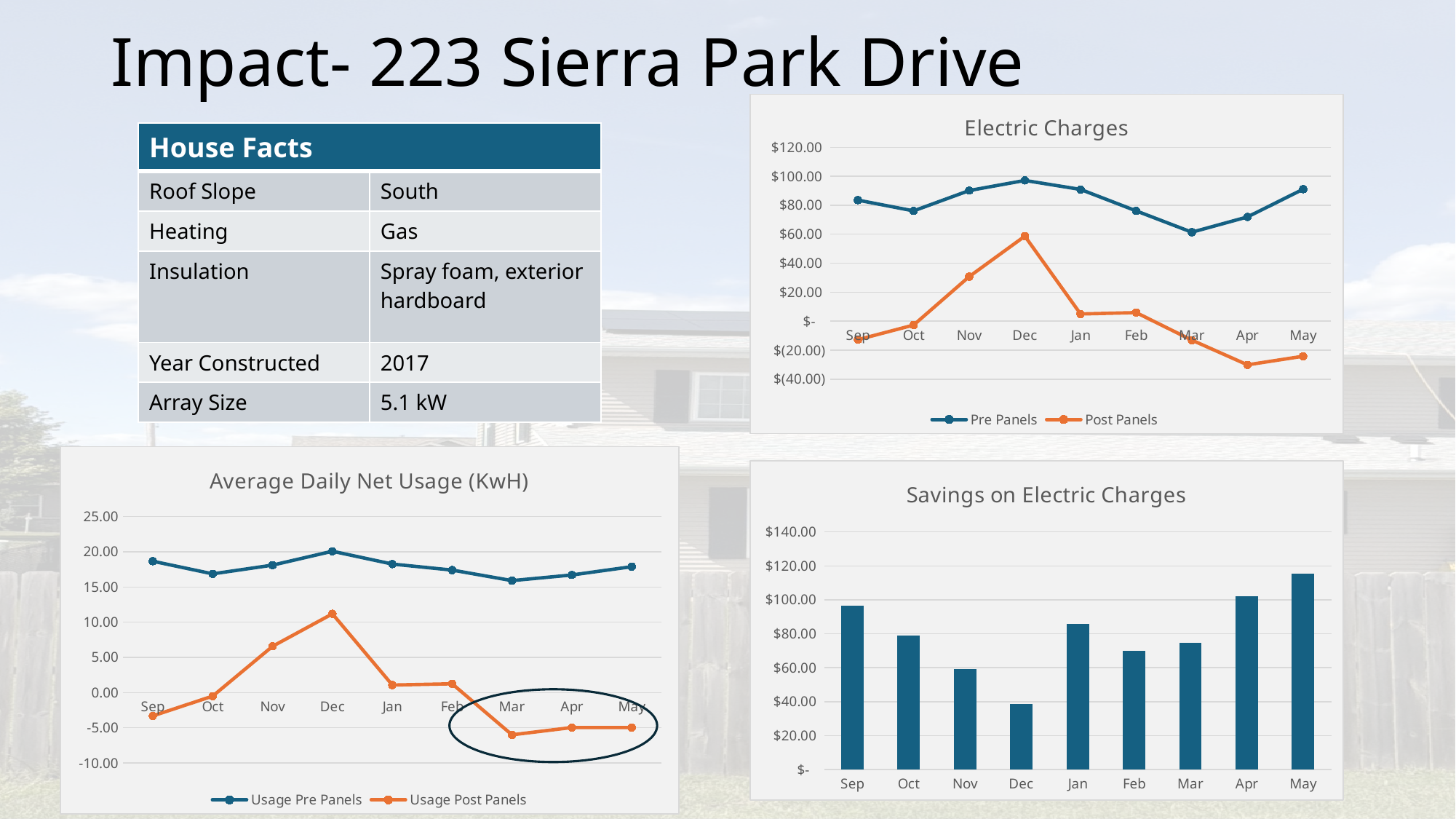
In the 'Savings on Electric Charges' chart, which month has the lowest savings? Dec In the 'Electric Charges' chart, is the Post Panels value for Dec greater or less than $40.00? greater What kind of chart is the 'Savings on Electric Charges' chart? bar chart In the 'Electric Charges' chart, in which month does the Pre Panels series reach its highest value? Dec In the 'Savings on Electric Charges' chart, is the value for May greater or less than $100.00? greater What kind of chart is the 'Electric Charges' chart? line chart How many months are shown on the x axis of the 'Savings on Electric Charges' chart? 9 In the 'Savings on Electric Charges' chart, which is larger, the savings for Sep or for Oct? Sep In the 'Average Daily Net Usage (KwH)' chart, is the Usage Post Panels value for Mar greater or less than 0.00? less In the 'Average Daily Net Usage (KwH)' chart, in which month does the Usage Post Panels series reach its highest value? Dec In the 'Savings on Electric Charges' chart, which month has the highest savings? May How many series does the legend of the 'Electric Charges' chart list? 2